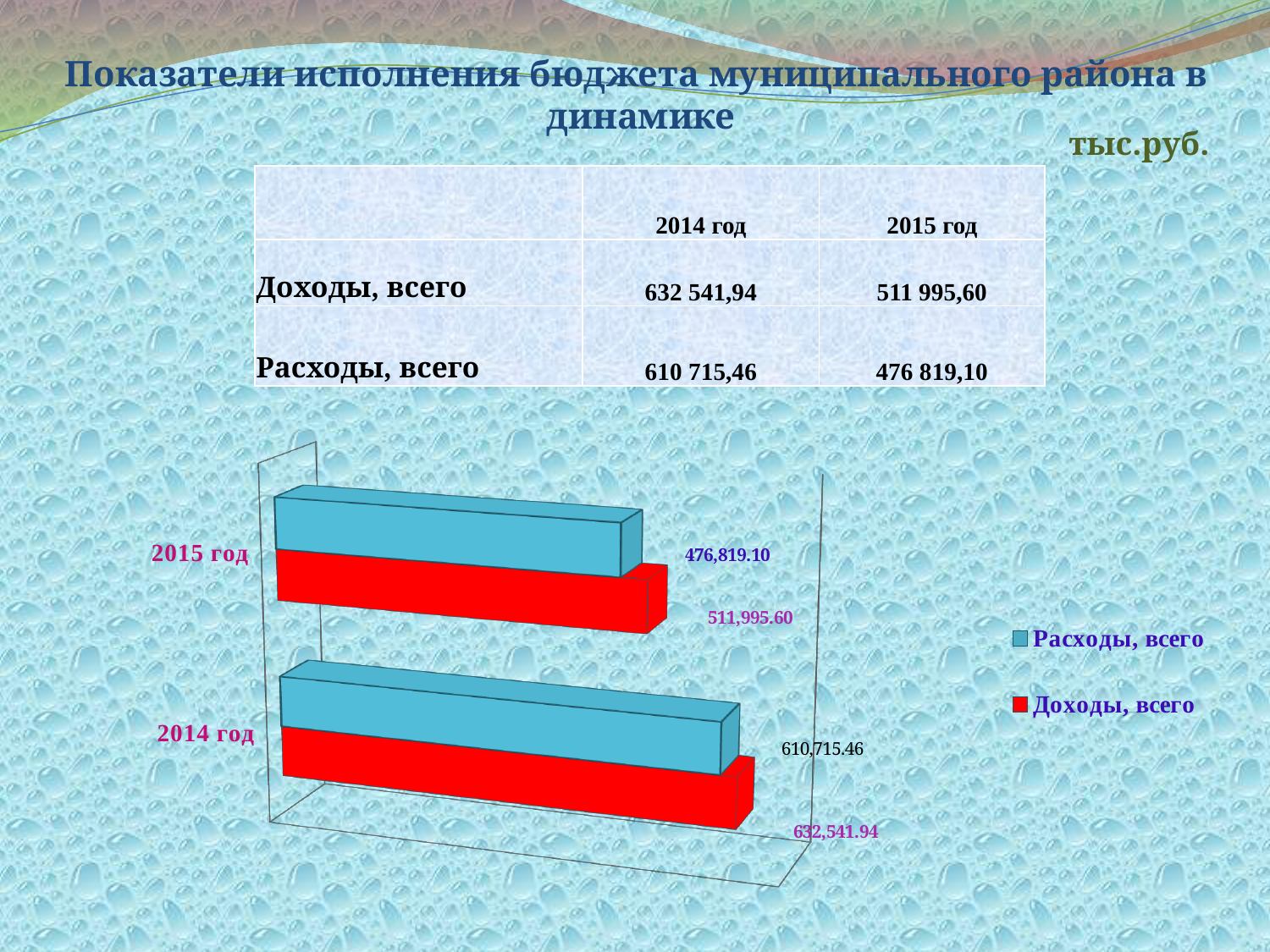
What is the value of Доходы, всего for 2014 год in the chart? 632,541.94 Which year has the lower value for Расходы, всего? 2015 год What colour are the bars for Расходы, всего in the chart? Blue What kind of chart is shown on the slide? Bar chart What is the value of Расходы, всего for 2015 год in the chart? 476,819.10 What is the value of Расходы, всего for 2014 год in the chart? 610,715.46 Which year has the higher value for Доходы, всего? 2014 год What is the value of Доходы, всего for 2015 год in the chart? 511,995.60 How many series does the chart legend list? 2 What is the difference between Доходы, всего and Расходы, всего for 2014 год? 21,826.48 Which is larger for 2015 год: Доходы, всего or Расходы, всего? Доходы, всего What is the difference between Доходы, всего and Расходы, всего for 2015 год? 35,176.50